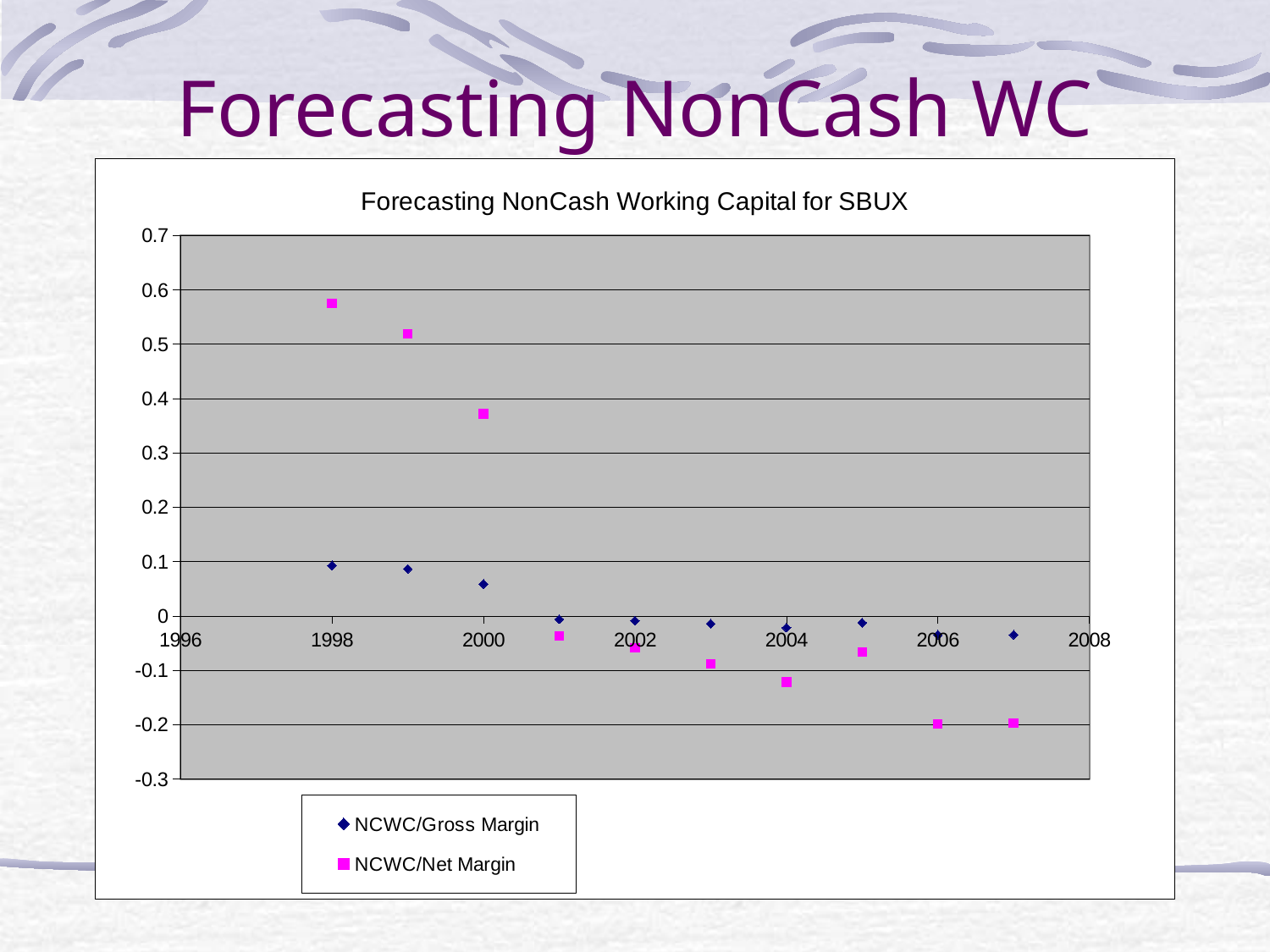
What is the title of the chart? Forecasting NonCash Working Capital for SBUX What kind of chart is shown on the slide? Scatter chart In 1998, which series has the larger value, NCWC/Gross Margin or NCWC/Net Margin? NCWC/Net Margin In which year is the NCWC/Net Margin value highest? 1998 Is the NCWC/Net Margin value for 1998 greater or less than 0.5? greater How many series does the legend list? 2 Do the NCWC/Net Margin values generally rise or fall from 1998 to 2007? fall Is the NCWC/Net Margin value for 2000 greater or less than 0.4? less Is the NCWC/Net Margin value for 2004 greater or less than -0.1? less In 2004, which series has the larger value, NCWC/Gross Margin or NCWC/Net Margin? NCWC/Gross Margin Which series is plotted with pink square markers? NCWC/Net Margin